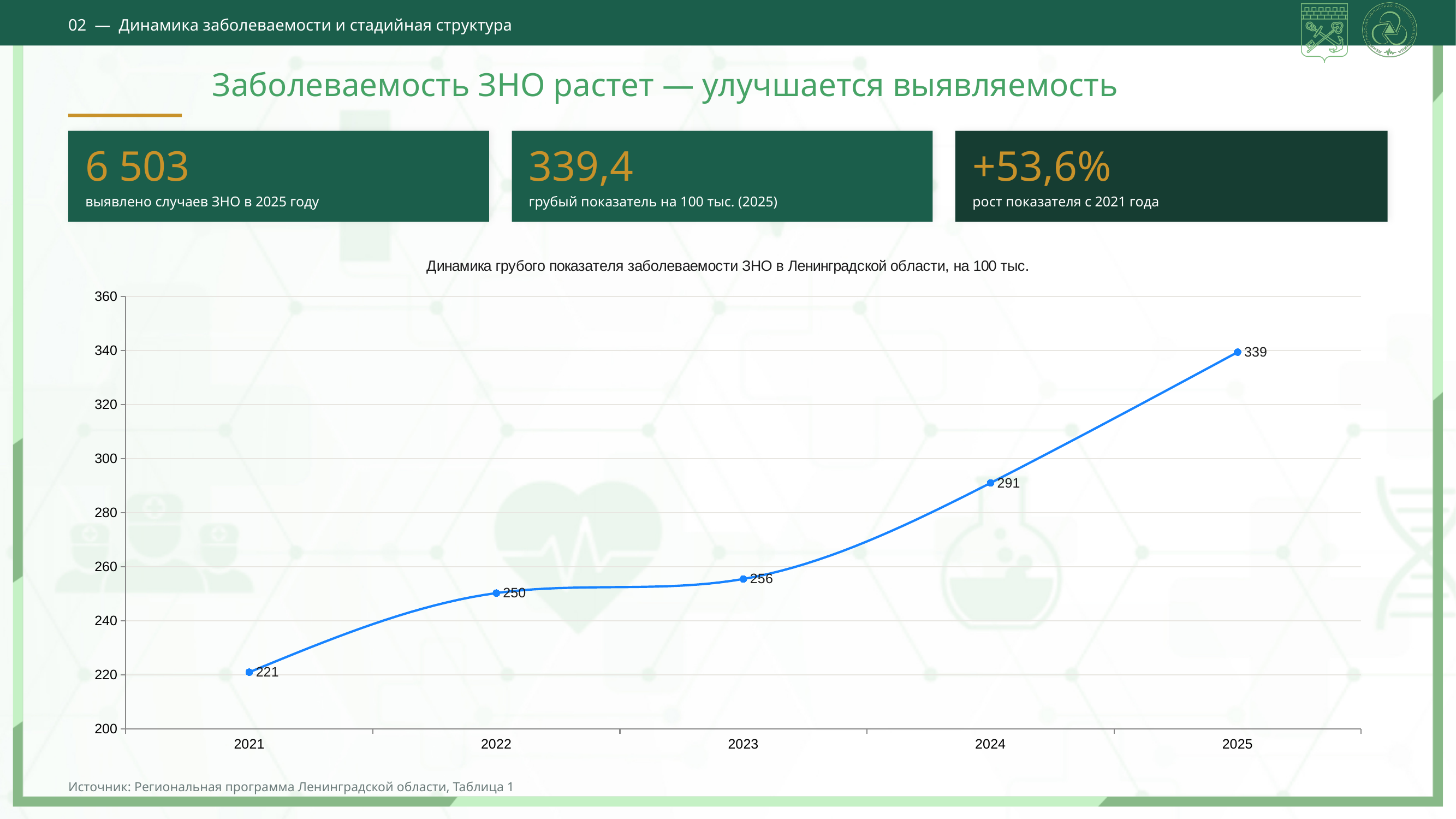
What is the value for 2025? 339 What is the difference between the values for 2024 and 2023? 35 What is the value for 2023? 256 What is the value for 2021? 221 How many years are plotted on the chart? 5 Which year has the highest value? 2025 What kind of chart is shown on the slide? line chart Which is larger, the value for 2022 or the value for 2024? 2024 Which year has the lowest value? 2021 Is the value for 2024 greater or less than 280? greater What is the difference between the values for 2025 and 2021? 118 Do the values rise or fall from 2021 to 2025? rise